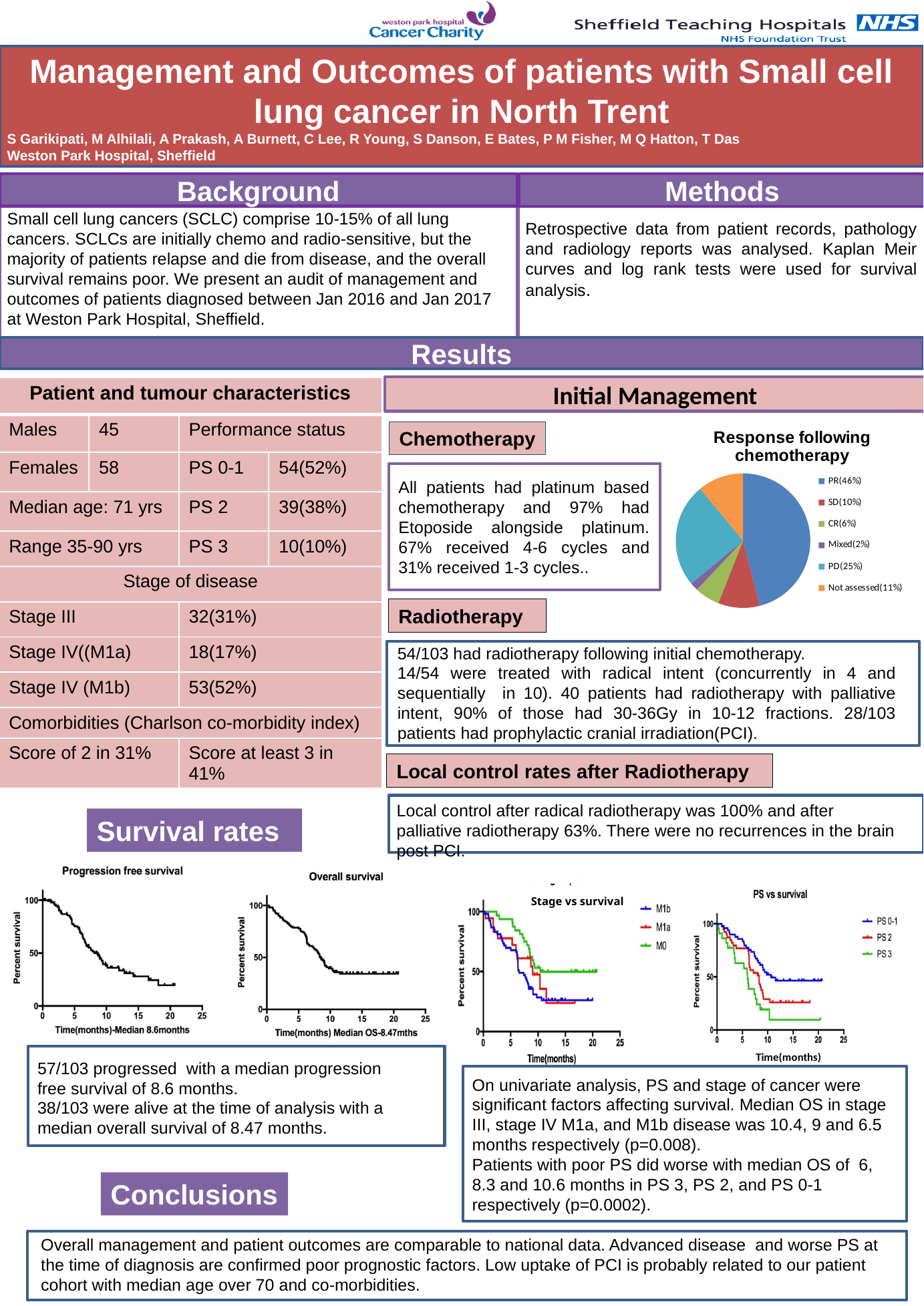
In the 'Response following chemotherapy' pie chart, which is larger, SD or CR? SD In the 'Overall survival' chart, does percent survival rise or fall as time in months increases? fall In the 'Response following chemotherapy' pie chart, what share of patients had PR? 46% In the 'Response following chemotherapy' pie chart, which response category has the smallest slice? Mixed In the 'Response following chemotherapy' pie chart, what share of patients were not assessed? 11% How many series does the legend of the 'Stage vs survival' chart list? 3 In the 'Response following chemotherapy' pie chart, how many response categories are shown? 6 In the 'Response following chemotherapy' pie chart, which response category has the largest slice? PR In the 'Response following chemotherapy' pie chart, what share of patients had PD? 25% How many series does the legend of the 'PS vs survival' chart list? 3 What kind of chart is the 'Response following chemotherapy' chart? pie chart In the 'Response following chemotherapy' pie chart, what is the difference in percentage points between PR and PD? 21